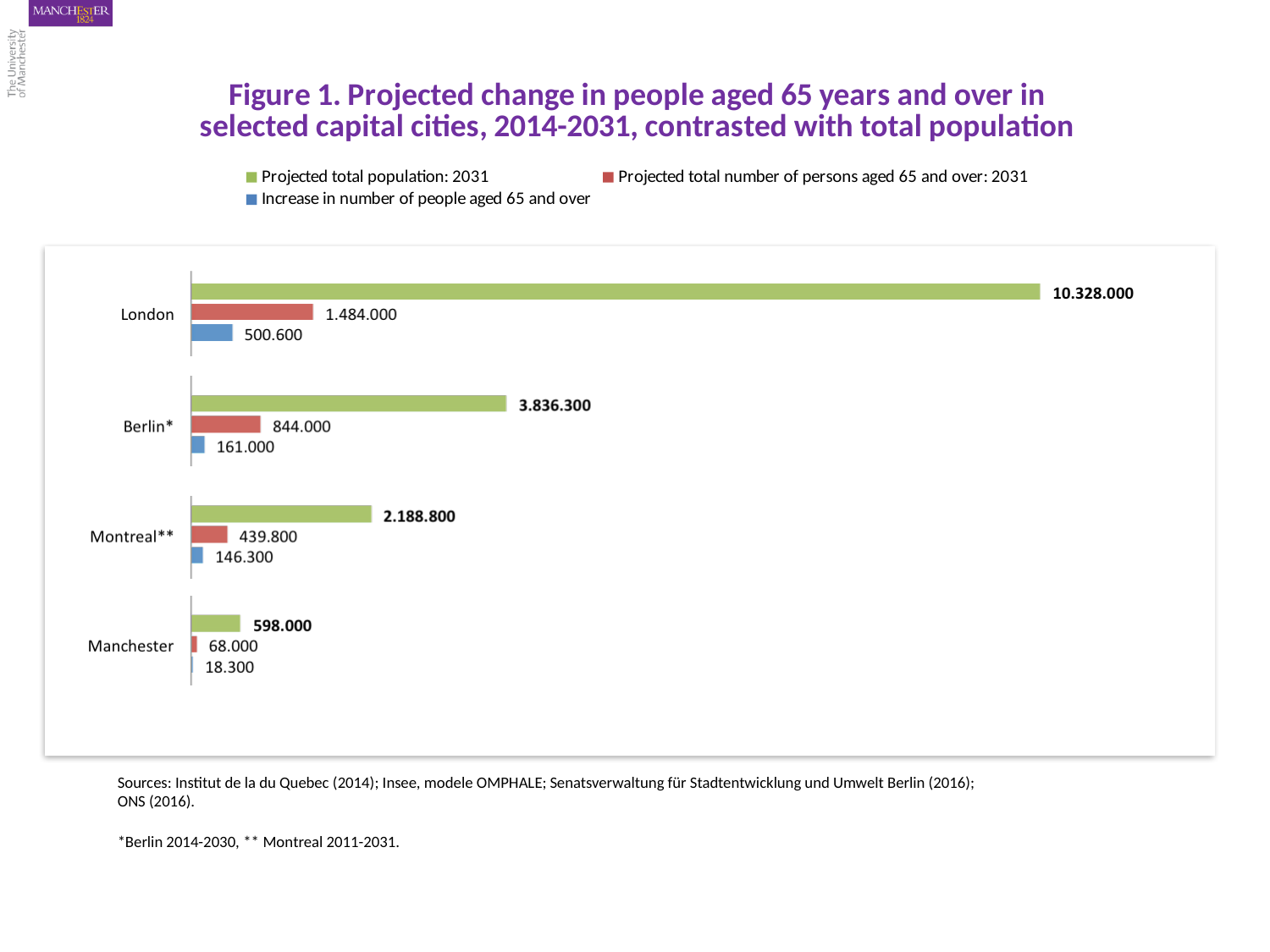
What kind of chart is shown on the slide? Bar chart What is the projected total number of persons aged 65 and over in 2031 for Berlin*? 844.000 What is the projected total population in 2031 for London? 10.328.000 What is the difference between the projected total population in 2031 for London and for Berlin*? 6.491.700 How many cities are shown in the chart? 4 Which city has the lowest increase in number of people aged 65 and over? Manchester What is the difference between the projected total number of persons aged 65 and over in 2031 for Berlin* and for Montreal**? 404.200 What is the projected total population in 2031 for Manchester? 598.000 What is the increase in number of people aged 65 and over for Montreal**? 146.300 How many series does the legend list? 3 Which is larger: the increase in number of people aged 65 and over for London or for Berlin*? London Which city has the highest projected total population in 2031? London